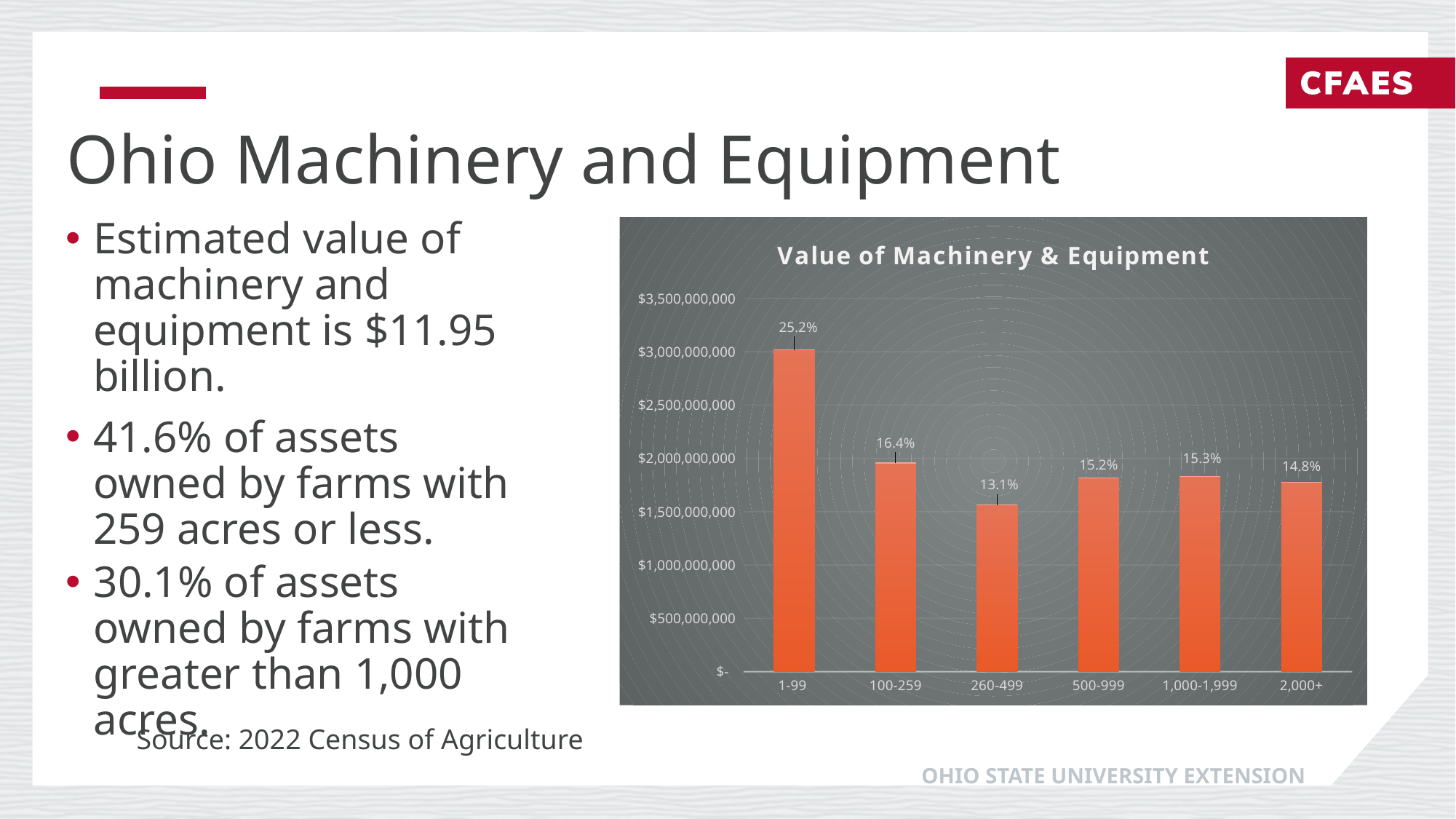
What percentage label is shown on the bar for the 260-499 category? 13.1% Which farm-size category has the highest value of machinery and equipment? 1-99 What is the difference in percentage points between the labels for the 1-99 and 100-259 categories? 8.8% What is the title of the chart? Value of Machinery & Equipment Is the value for the 1-99 category greater or less than $2,500,000,000? greater What percentage label is shown on the bar for the 2,000+ category? 14.8% Which farm-size category has the lowest value of machinery and equipment? 260-499 Is the value for the 260-499 category greater or less than $2,000,000,000? less How many farm-size categories are shown on the x axis of the chart? 6 Which category has a larger value, 1-99 or 100-259? 1-99 What percentage label is shown on the bar for the 1-99 category? 25.2% What kind of chart is shown on the slide? Bar chart